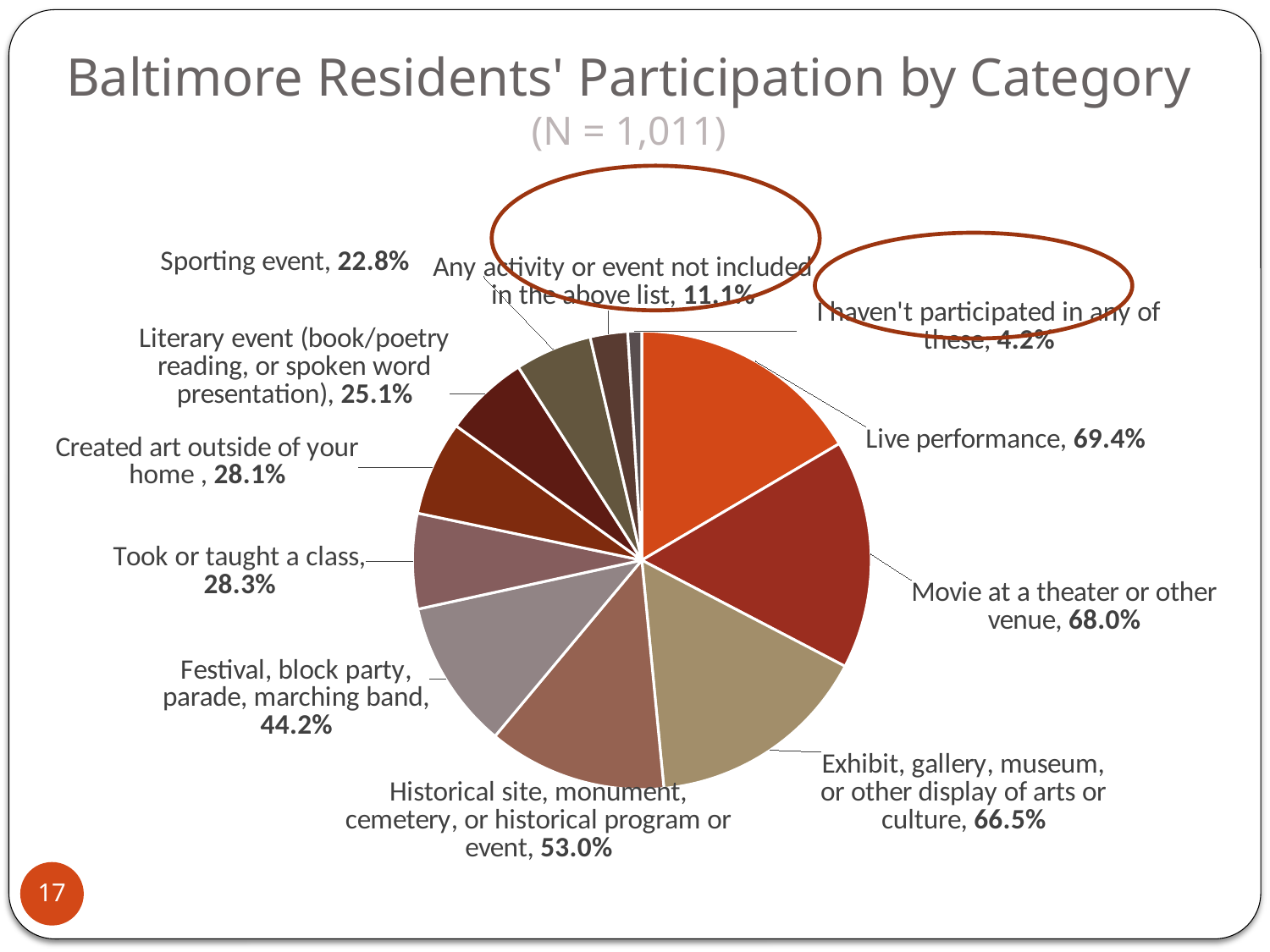
What is the value for Sporting event? 22.8% What is the value for Live performance? 69.4% What kind of chart is shown on the slide? pie chart Which category has the lowest value? I haven't participated in any of these How many categories are shown in the pie chart? 11 What is the difference between the values for Live performance and Movie at a theater or other venue? 1.4% Which category has the highest value? Live performance What is the value for Festival, block party, parade, marching band? 44.2% What is the difference between the values for Festival, block party, parade, marching band and Sporting event? 21.4% What is the value for Historical site, monument, cemetery, or historical program or event? 53.0% What sample size (N) is stated in the chart title? 1,011 Which is larger, the value for Took or taught a class or the value for Literary event? Took or taught a class